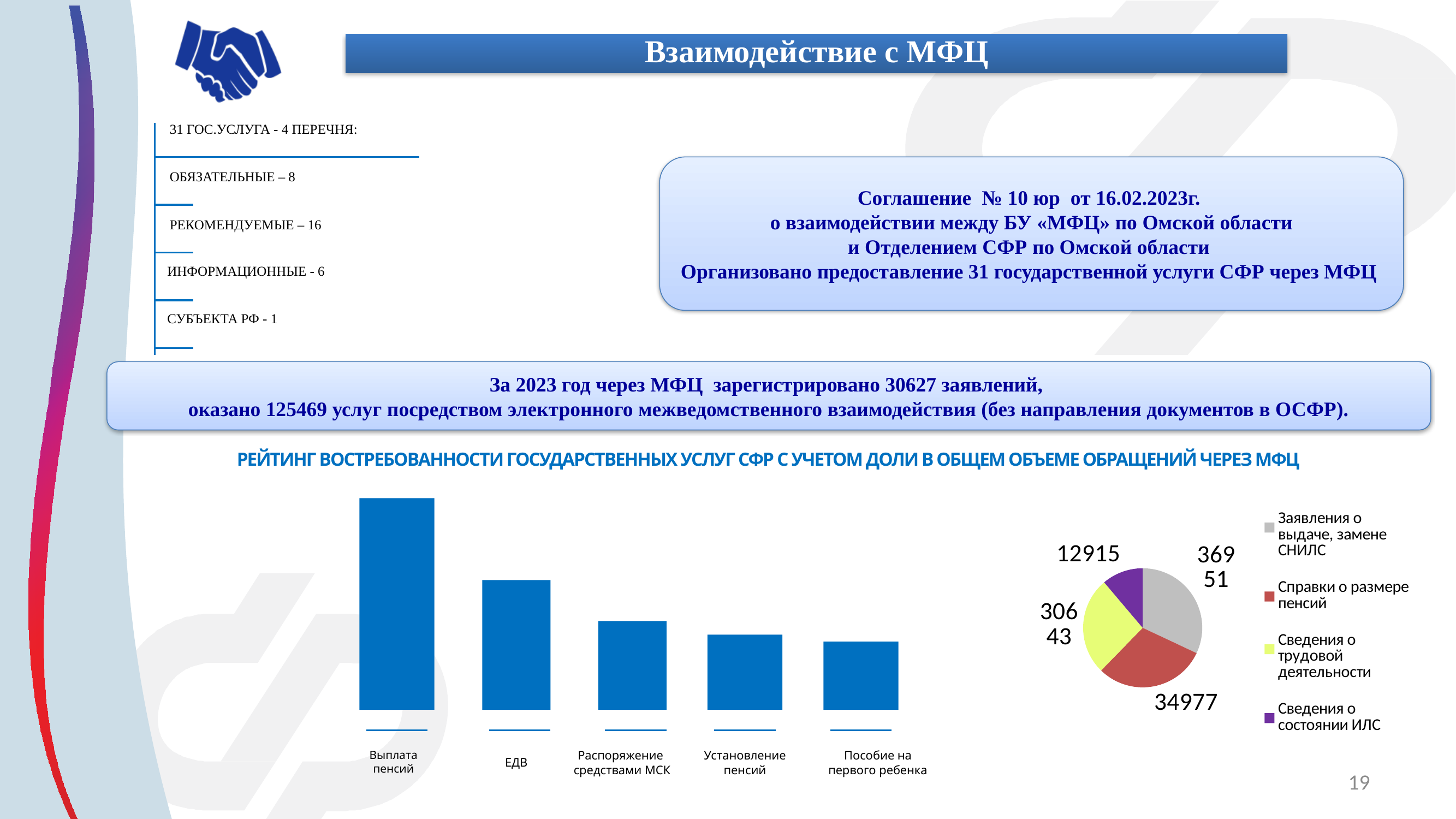
In the pie chart, what is the value for 'Сведения о состоянии ИЛС'? 12915 In the left bar chart, do the bars rise or fall from left to right? Fall In the pie chart, which slice is the smallest? Сведения о состоянии ИЛС In the left bar chart, which category has the highest bar? Выплата пенсий What kind of chart is the left chart under the heading 'РЕЙТИНГ ВОСТРЕБОВАННОСТИ ГОСУДАРСТВЕННЫХ УСЛУГ СФР'? Bar chart How many entries does the legend of the pie chart list? 4 In the left bar chart, which is larger: ЕДВ or Установление пенсий? ЕДВ How many categories does the left bar chart show? 5 What kind of chart is the right chart on the slide? Pie chart In the left bar chart, which category has the lowest bar? Пособие на первого ребенка In the pie chart, what is the difference between 'Справки о размере пенсий' and 'Сведения о состоянии ИЛС'? 22062 In the pie chart, what is the value for 'Справки о размере пенсий'? 34977